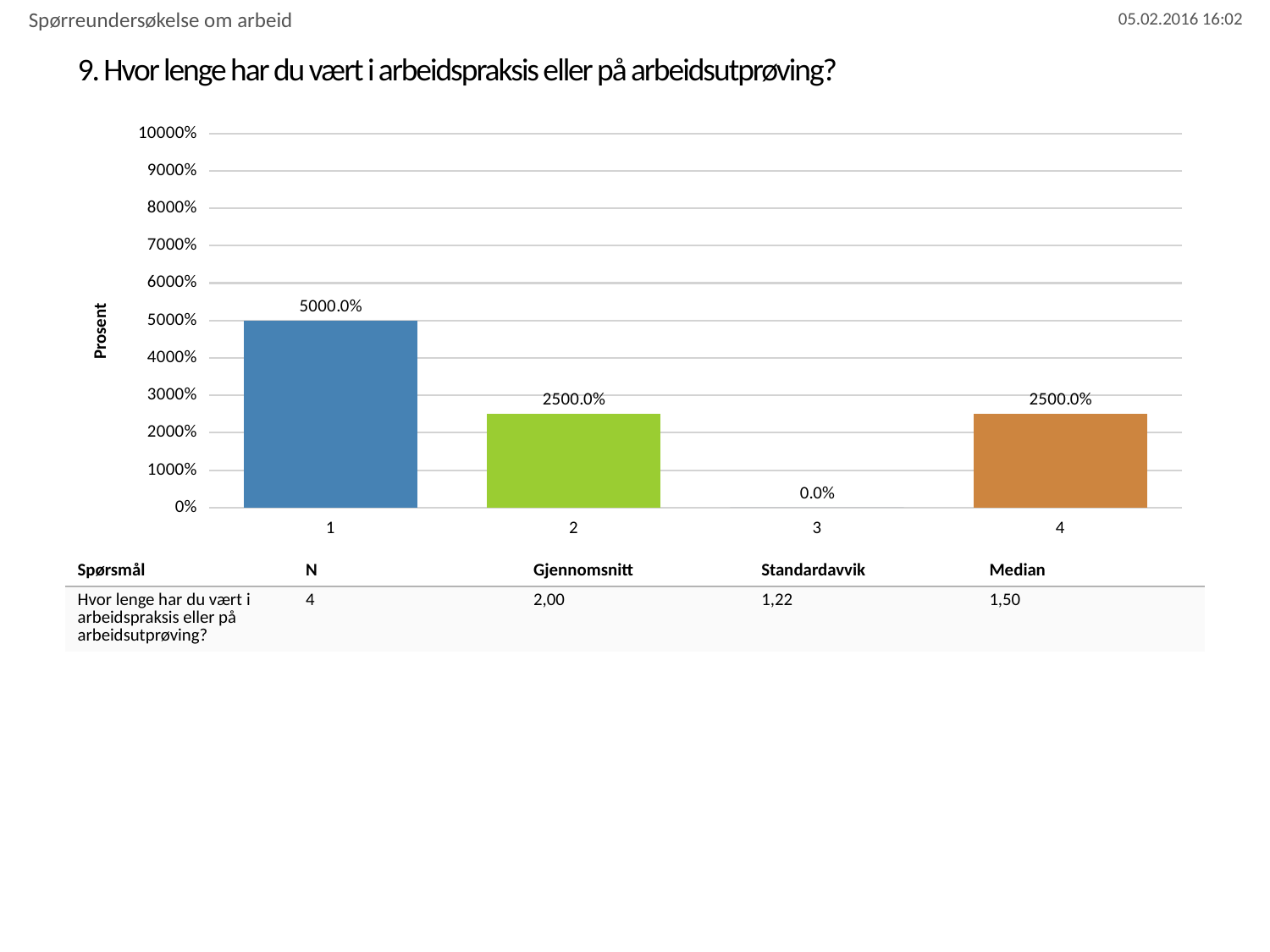
What is the value for category 4? 2500.0% What kind of chart is shown on the slide? bar chart Which category has the lowest value? 3 What is the label of the y axis? Prosent What is the difference between the values for category 1 and category 2? 2500.0% What is the value for category 2? 2500.0% Is the value for category 1 greater or less than 4000%? greater Which is larger, the value for category 1 or the value for category 4? 1 What is the value for category 3? 0.0% Which category has the highest value? 1 How many categories are shown on the x axis? 4 What is the value for category 1? 5000.0%